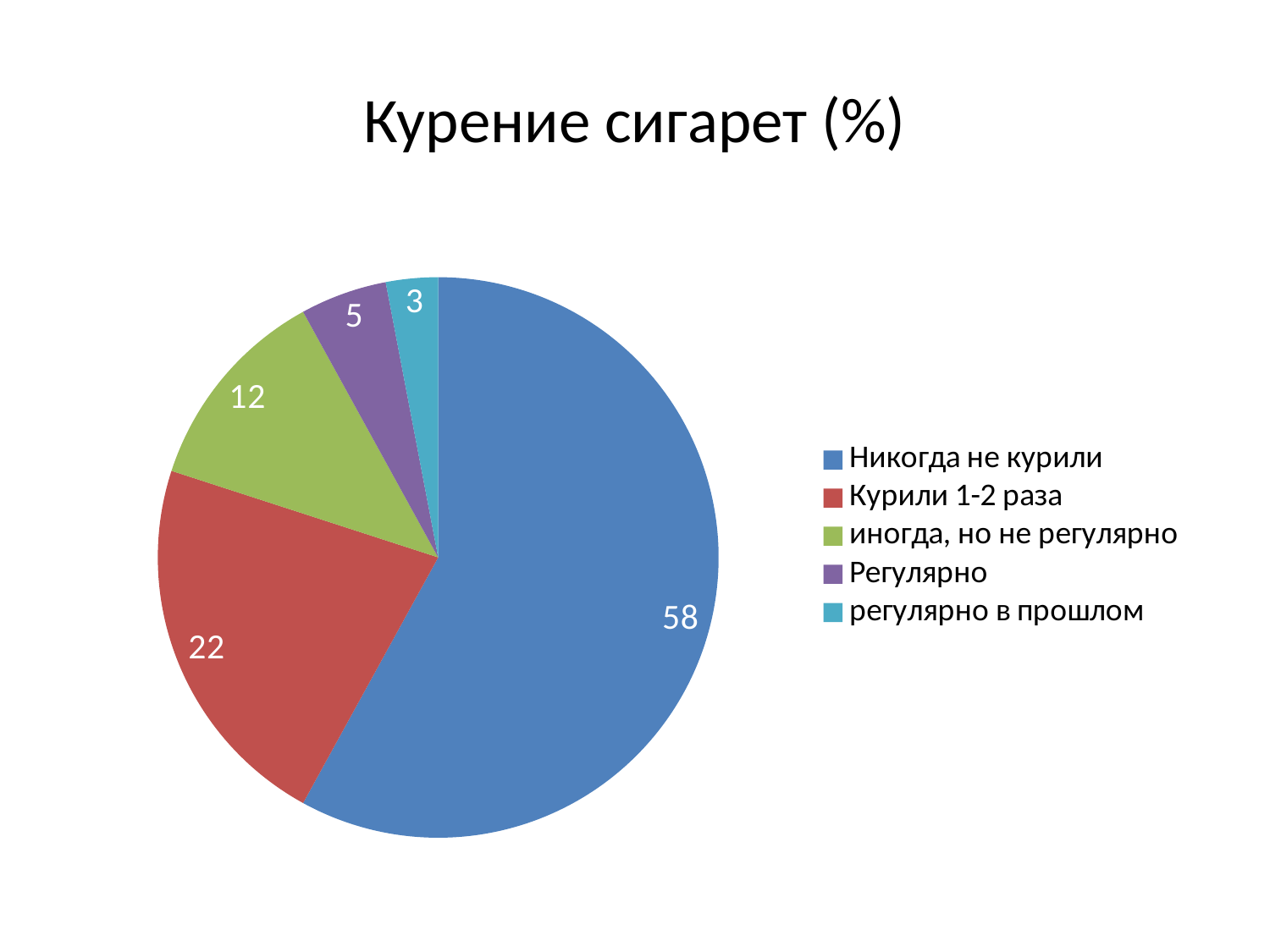
What is the value for "иногда, но не регулярно"? 12 What is the value for "Регулярно"? 5 What is the title of the chart? Курение сигарет (%) What type of chart is shown on the slide? pie chart Which category has the largest slice? Никогда не курили What is the value for "регулярно в прошлом"? 3 How many categories does the legend list? 5 Which is larger, the value for "иногда, но не регулярно" or the value for "Регулярно"? иногда, но не регулярно Which category has the smallest slice? регулярно в прошлом What is the value for "Курили 1-2 раза"? 22 What is the difference between the values for "Никогда не курили" and "Курили 1-2 раза"? 36 What is the value for "Никогда не курили"? 58